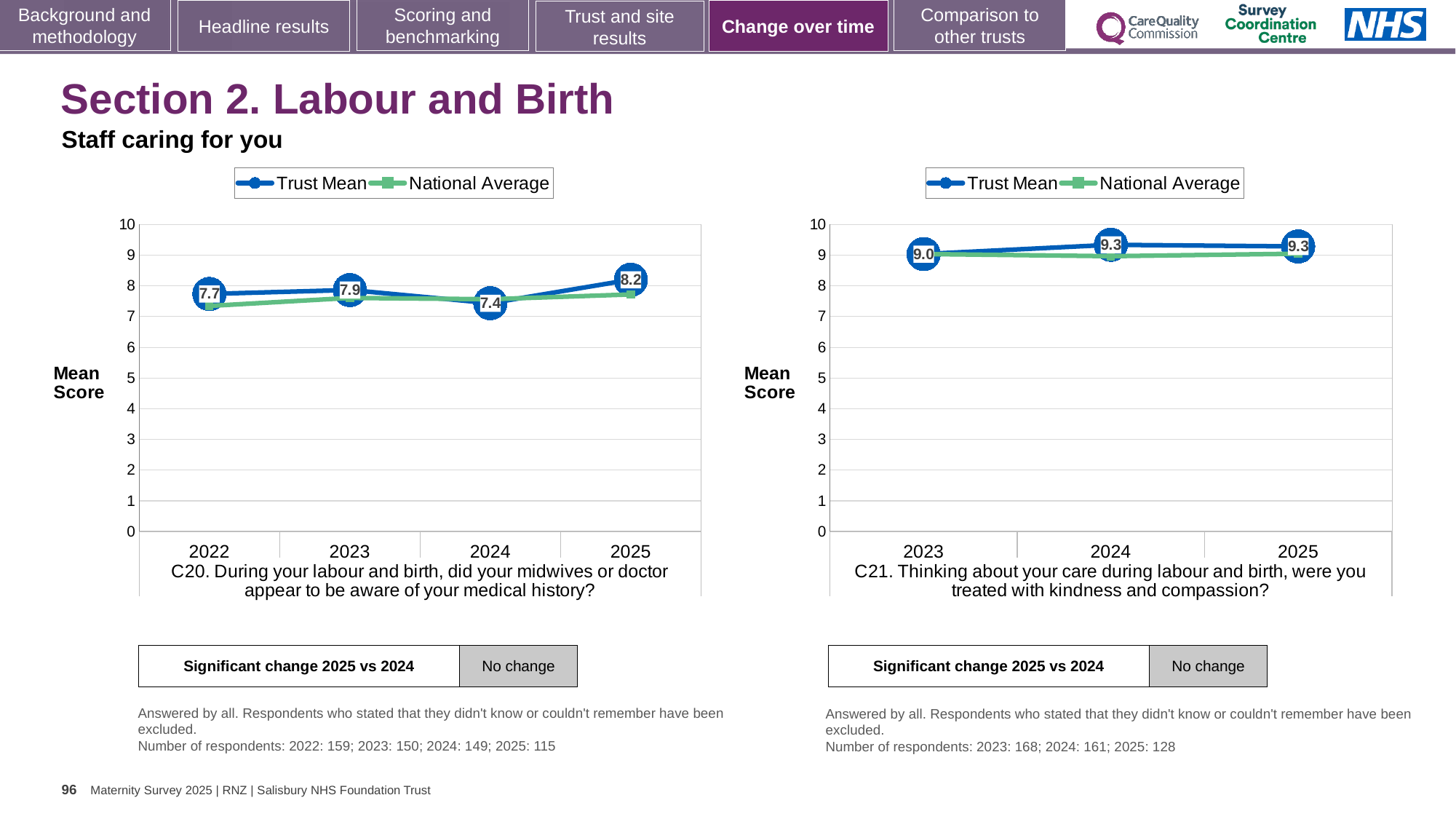
In the C20 chart, which year has the highest Trust Mean score? 2025 In the C20 chart, is the Trust Mean score for 2023 greater than the Trust Mean score for 2024? Yes In the C20 chart, what is the Trust Mean score for 2025? 8.2 In the C21 chart, what is the Trust Mean score for 2025? 9.3 In the C20 chart, what is the difference between the Trust Mean scores for 2025 and 2024? 0.8 In the C21 chart, how many series does the legend list? 2 In the C21 chart, is the National Average for 2025 greater or less than 8? greater What kind of chart is the C20 chart? Line chart In the C20 chart, which year has the lowest Trust Mean score? 2024 In the C21 chart, what is the Trust Mean score for 2023? 9.0 In the C20 chart, what is the Trust Mean score for 2022? 7.7 In the C20 chart, how many years are plotted on the x axis? 4